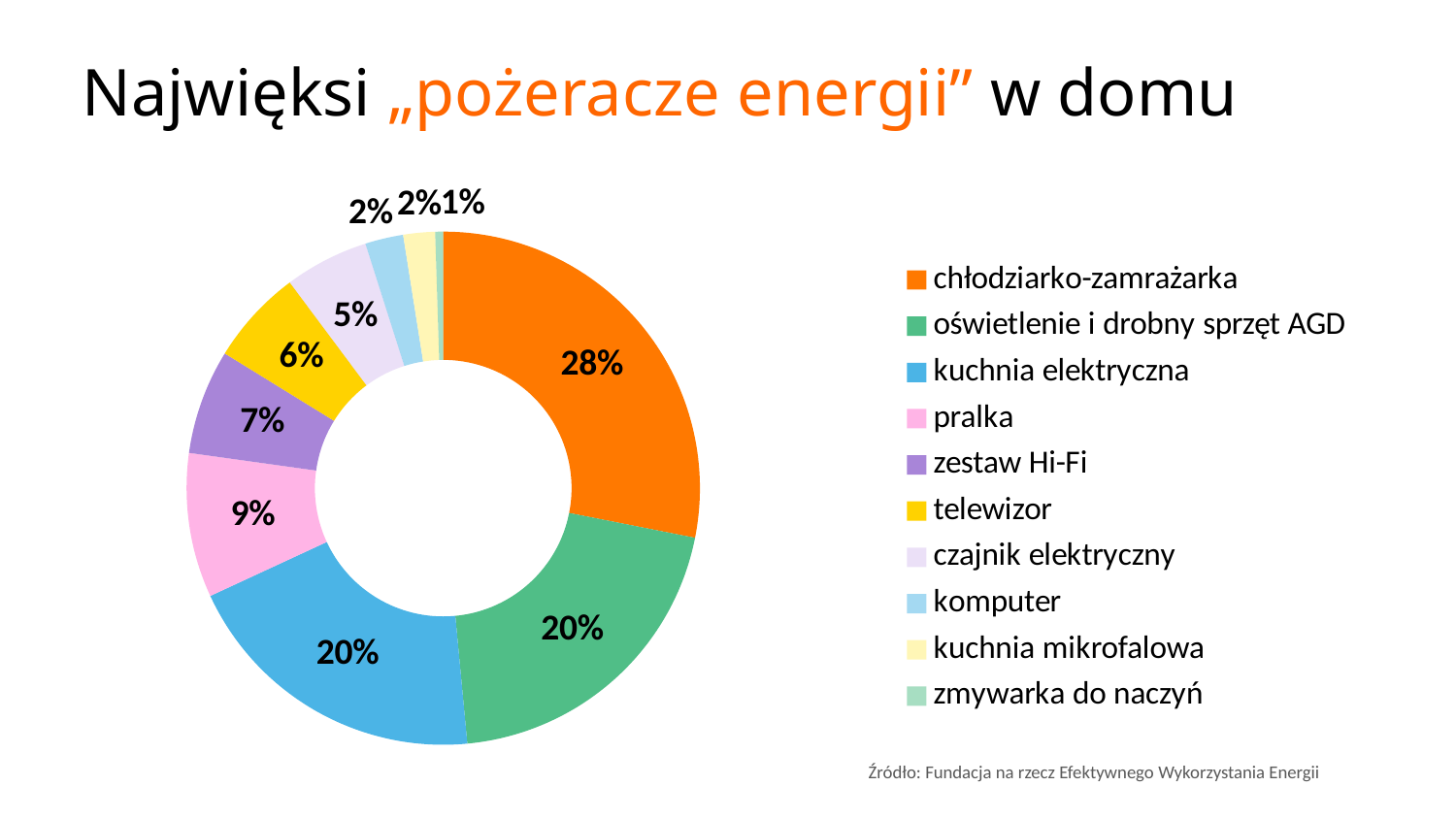
Which category has the largest share of the chart? chłodziarko-zamrażarka What is the combined share of oświetlenie i drobny sprzęt AGD and kuchnia elektryczna? 40% Which colour represents kuchnia elektryczna in the legend? blue What is the difference between the shares of chłodziarko-zamrażarka and kuchnia elektryczna? 8% What kind of chart is shown on the slide? doughnut chart What share of the chart does chłodziarko-zamrażarka account for? 28% Which category has the smallest share of the chart? zmywarka do naczyń What percentage is shown for telewizor? 6% What is the value shown for pralka? 9% Which has a larger share, zestaw Hi-Fi or telewizor? zestaw Hi-Fi How many categories are shown in the chart? 10 What is the value for czajnik elektryczny? 5%